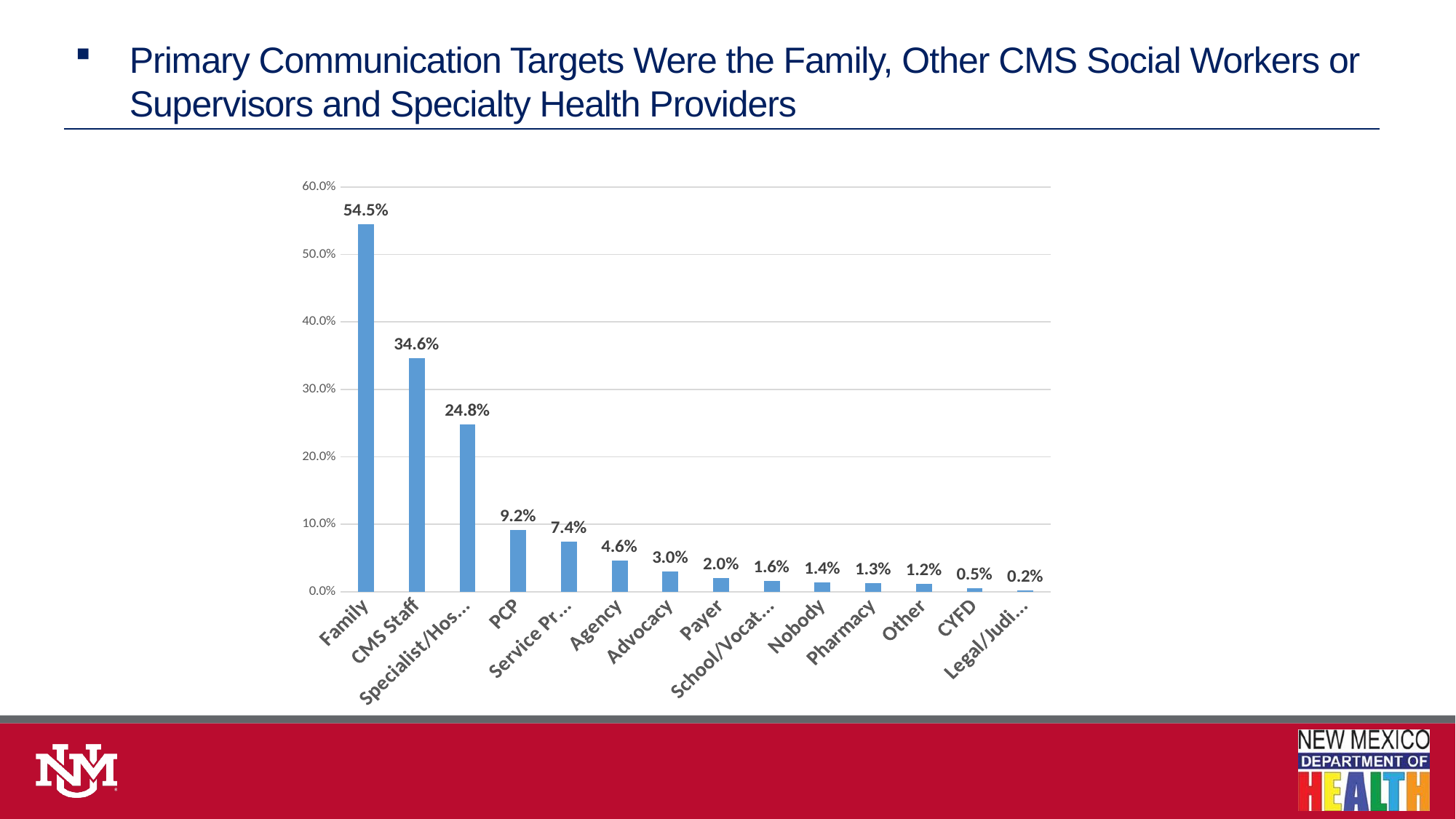
What is the value for Family? 54.5% Which is larger, the value for Agency or the value for Advocacy? Agency What is the value for CMS Staff? 34.6% Do the values rise or fall from left to right along the x axis? Fall Is the value for Family greater or less than 50.0%? greater Which category has the highest value? Family What is the value for CYFD? 0.5% What is the difference between the values for Family and CMS Staff? 19.9% What kind of chart is shown on the slide? Bar chart What is the value for Pharmacy? 1.3% What is the value for PCP? 9.2% How many categories are shown on the x axis? 14